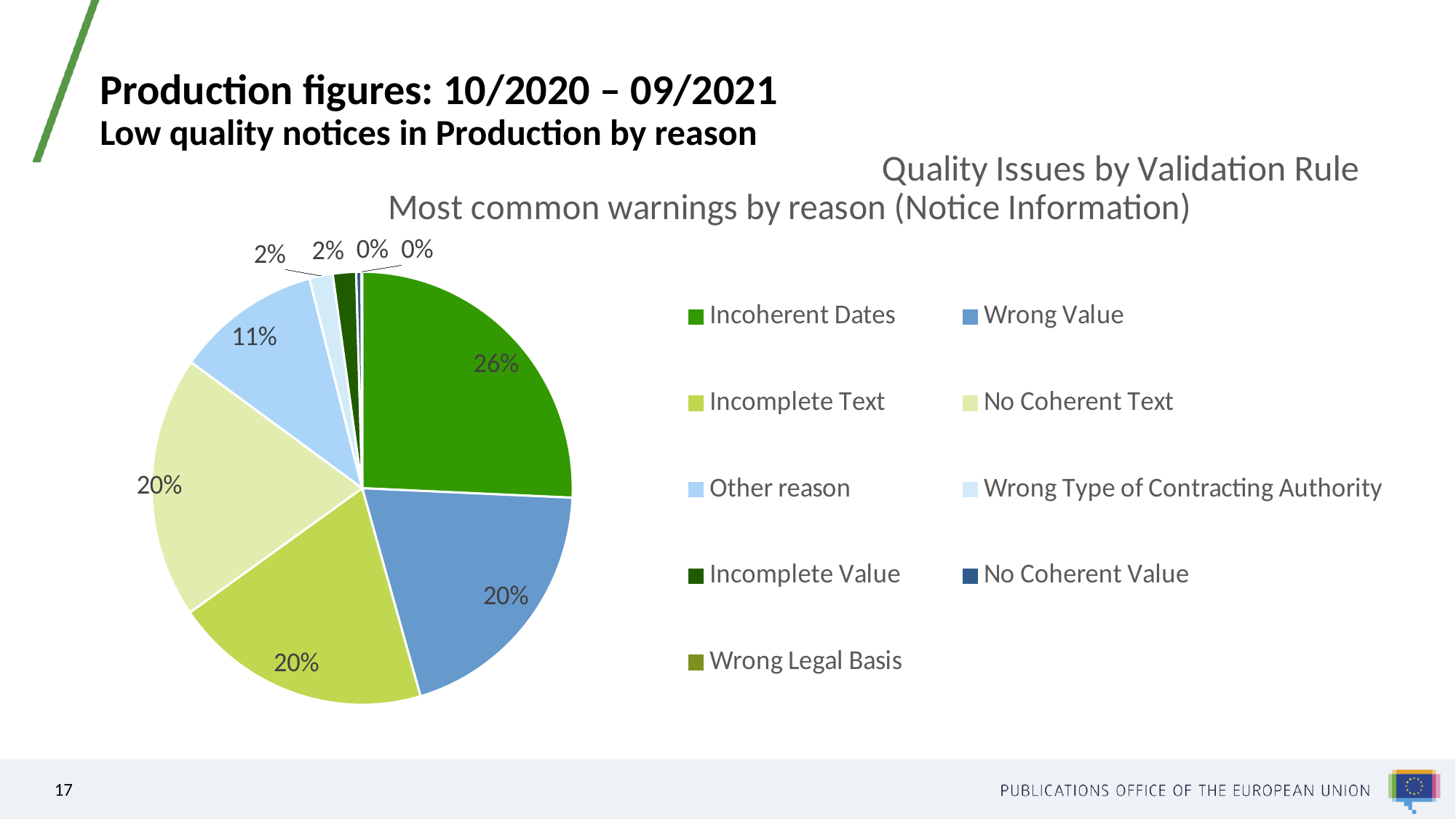
What is the value shown for Incomplete Value? 2% Which is larger, the slice for Incoherent Dates or the slice for Wrong Value? Incoherent Dates Which reason has the largest slice of the pie? Incoherent Dates What share of the pie does Incoherent Dates account for? 26% What is the difference in percentage points between Incoherent Dates and Other reason? 15% Which legend entry is shown with a dark blue marker? No Coherent Value How many categories does the legend list? 9 Which is larger, the slice for No Coherent Text or the slice for Other reason? No Coherent Text What kind of chart is shown on the slide? pie chart What is the value shown for Wrong Value? 20% What is the value shown for Other reason? 11% What is the subtitle of the chart shown below 'Quality Issues by Validation Rule'? Most common warnings by reason (Notice Information)